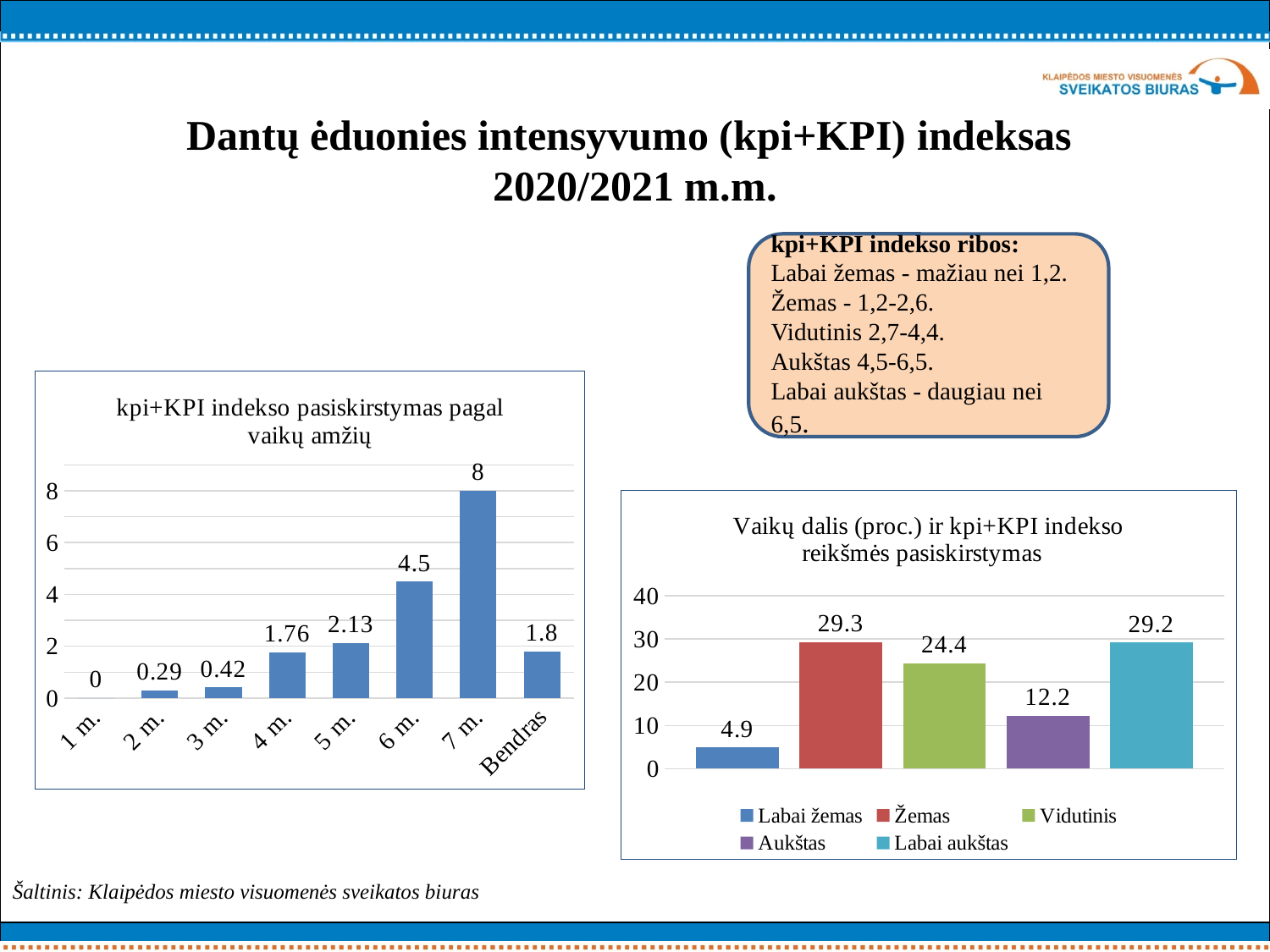
In the chart 'kpi+KPI indekso pasiskirstymas pagal vaikų amžių', which age group has the lowest value? 1 m. In the chart 'kpi+KPI indekso pasiskirstymas pagal vaikų amžių', do the values rise or fall from 1 m. to 7 m.? rise In the chart 'kpi+KPI indekso pasiskirstymas pagal vaikų amžių', how many categories are shown on the x axis? 8 In the chart 'kpi+KPI indekso pasiskirstymas pagal vaikų amžių', which age group has the highest value? 7 m. What kind of chart is 'Vaikų dalis (proc.) ir kpi+KPI indekso reikšmės pasiskirstymas'? bar chart In the chart 'Vaikų dalis (proc.) ir kpi+KPI indekso reikšmės pasiskirstymas', which is larger, Vidutinis or Aukštas? Vidutinis In the chart 'kpi+KPI indekso pasiskirstymas pagal vaikų amžių', what is the value for 6 m.? 4.5 In the chart 'kpi+KPI indekso pasiskirstymas pagal vaikų amžių', what is the difference between the values for 7 m. and 6 m.? 3.5 In the chart 'Vaikų dalis (proc.) ir kpi+KPI indekso reikšmės pasiskirstymas', which category has the lowest value? Labai žemas In the chart 'Vaikų dalis (proc.) ir kpi+KPI indekso reikšmės pasiskirstymas', how many entries does the legend list? 5 In the chart 'kpi+KPI indekso pasiskirstymas pagal vaikų amžių', what is the value for Bendras? 1.8 In the chart 'Vaikų dalis (proc.) ir kpi+KPI indekso reikšmės pasiskirstymas', what is the value for Vidutinis? 24.4